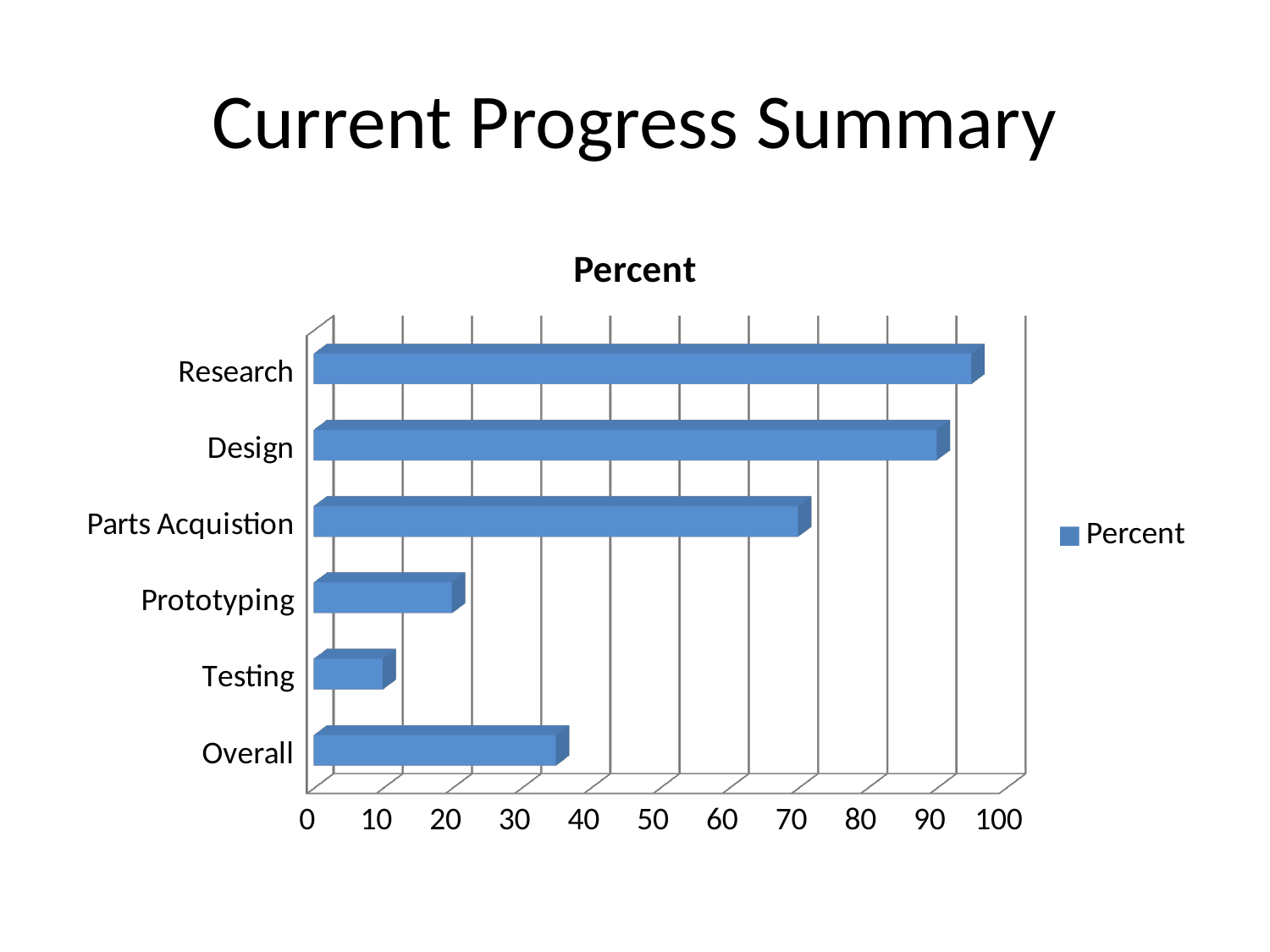
Is the value for Testing greater or less than 20? less How many series does the legend list? 1 Which category has the lowest value? Testing What is the title of the chart? Percent Which category has the highest value? Research How many categories are plotted on the chart? 6 Is the value for Parts Acquistion greater or less than 60? greater Is the value for Prototyping greater or less than 30? less What kind of chart is shown on the slide? bar chart Which is larger, the value for Design or the value for Parts Acquistion? Design